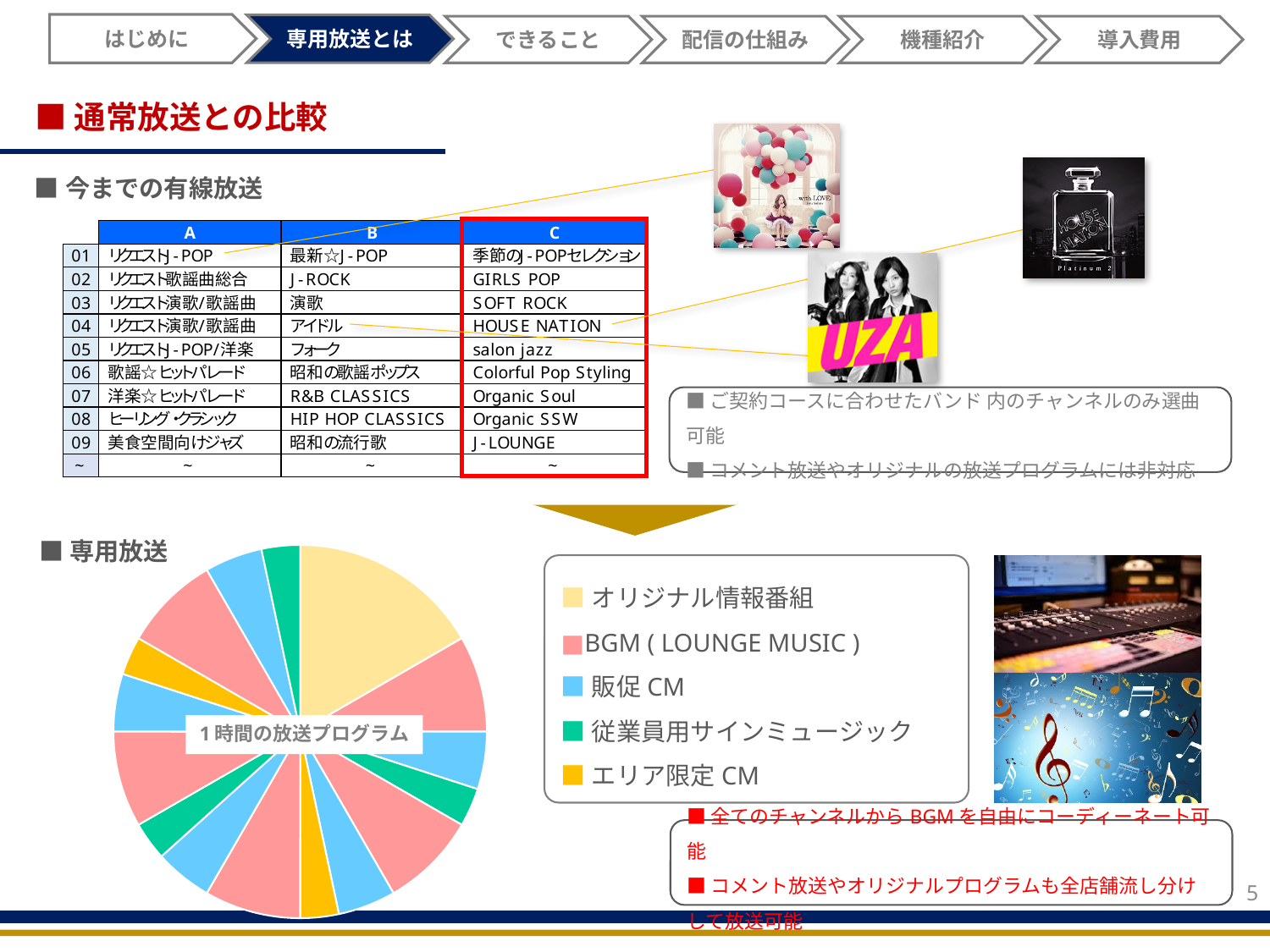
What is the label written in the centre of the pie chart? 1時間の放送プログラム Which category has the largest single slice in the pie chart? オリジナル情報番組 How many entries does the legend of the pie chart list? 5 What kind of chart is shown at the bottom left of the slide? pie chart Which legend entry of the pie chart is shown in green? 従業員用サインミュージック In the pie chart, is the single オリジナル情報番組 slice larger or smaller than any single エリア限定 CM slice? larger